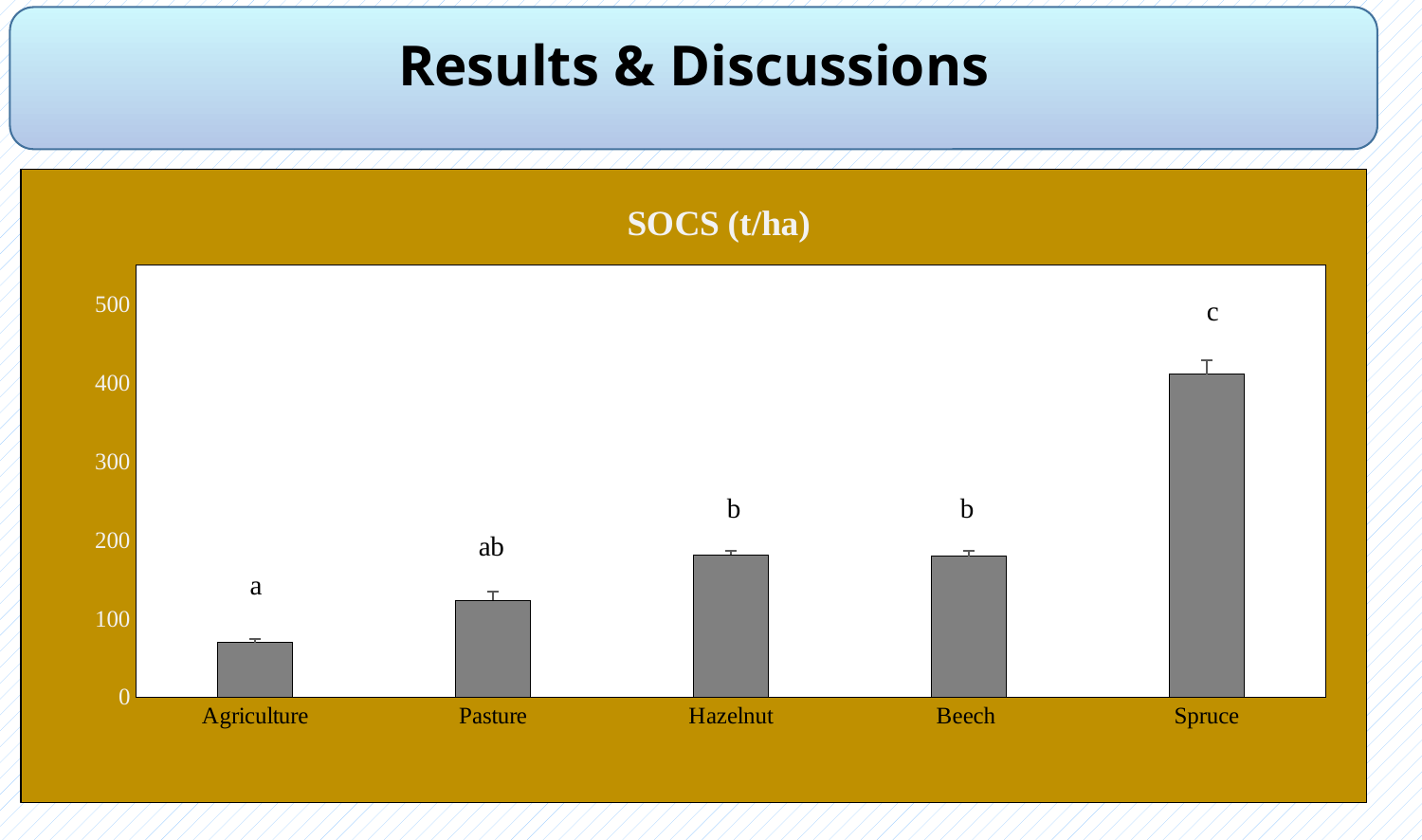
Which category has the lowest SOCS value? Agriculture Is the value for Pasture greater or less than 100? greater Which category has the highest SOCS value? Spruce Is the value for Hazelnut greater or less than 200? less Which has a larger SOCS value, Spruce or Pasture? Spruce Is the value for Spruce greater or less than 300? greater Which has a larger SOCS value, Agriculture or Hazelnut? Hazelnut How many categories are shown on the x axis of the chart? 5 What is the title of the chart? SOCS (t/ha) What kind of chart is shown on the slide? bar chart What letter label is printed above the Spruce bar? c